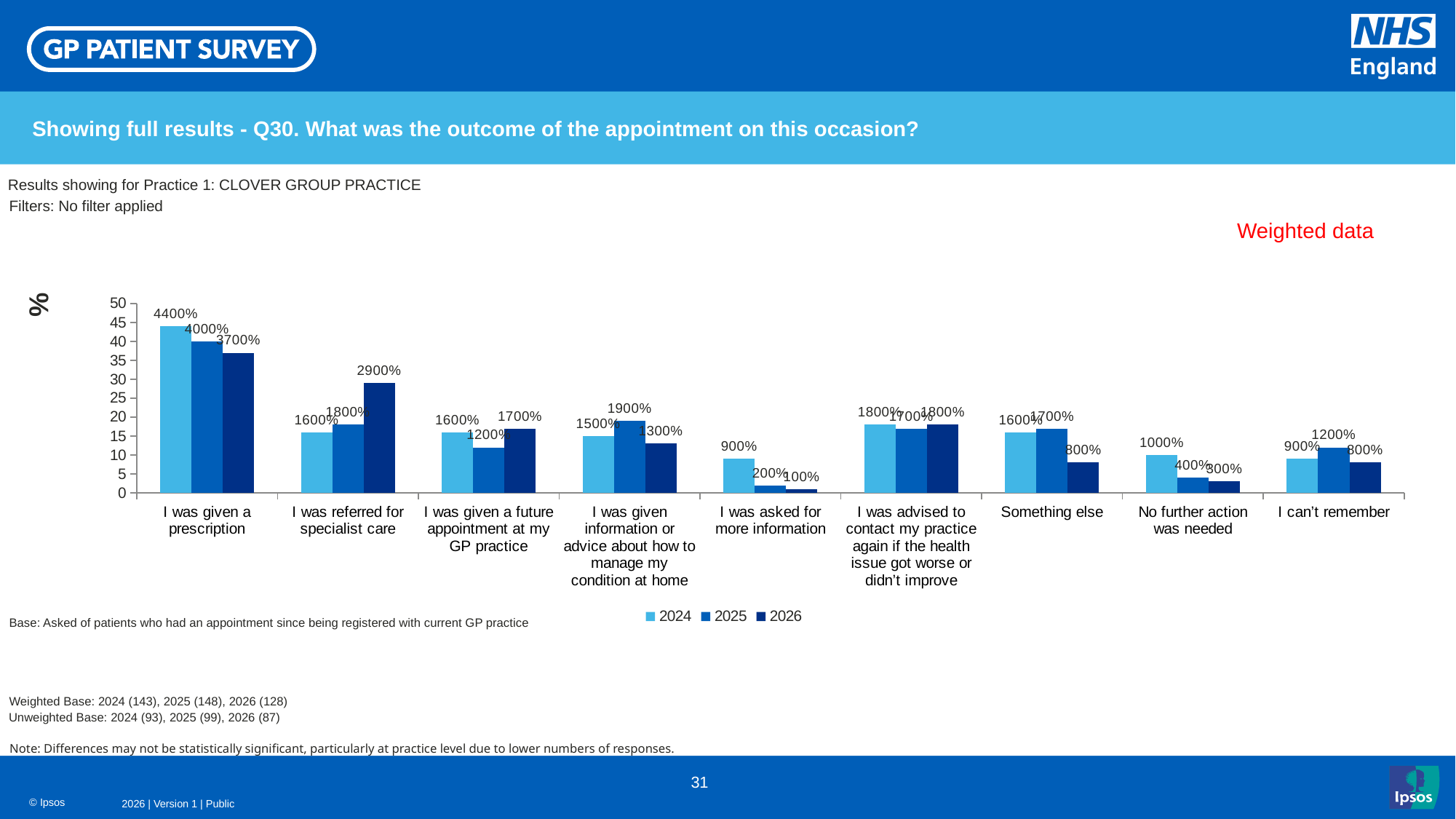
For 'Something else', which year has the larger value, 2025 or 2026? 2025 What kind of chart is shown on the slide? bar chart What is the difference between the 2026 and 2024 data labels for 'I was referred for specialist care'? 1300% How many outcome categories are shown on the x axis? 9 Which category has the lowest 2026 value? I was asked for more information Do the values for 'I was given a prescription' rise or fall from 2024 to 2026? fall What is the data label for 2026 on the 'I was referred for specialist care' bar? 2900% Which category has the highest 2024 value? I was given a prescription What is the data label for 2025 on the 'I was asked for more information' bar? 200% What is the data label for 2024 on the 'I was given a prescription' bar? 4400% How many series does the legend list? 3 What is the data label for 2026 on the 'No further action was needed' bar? 300%